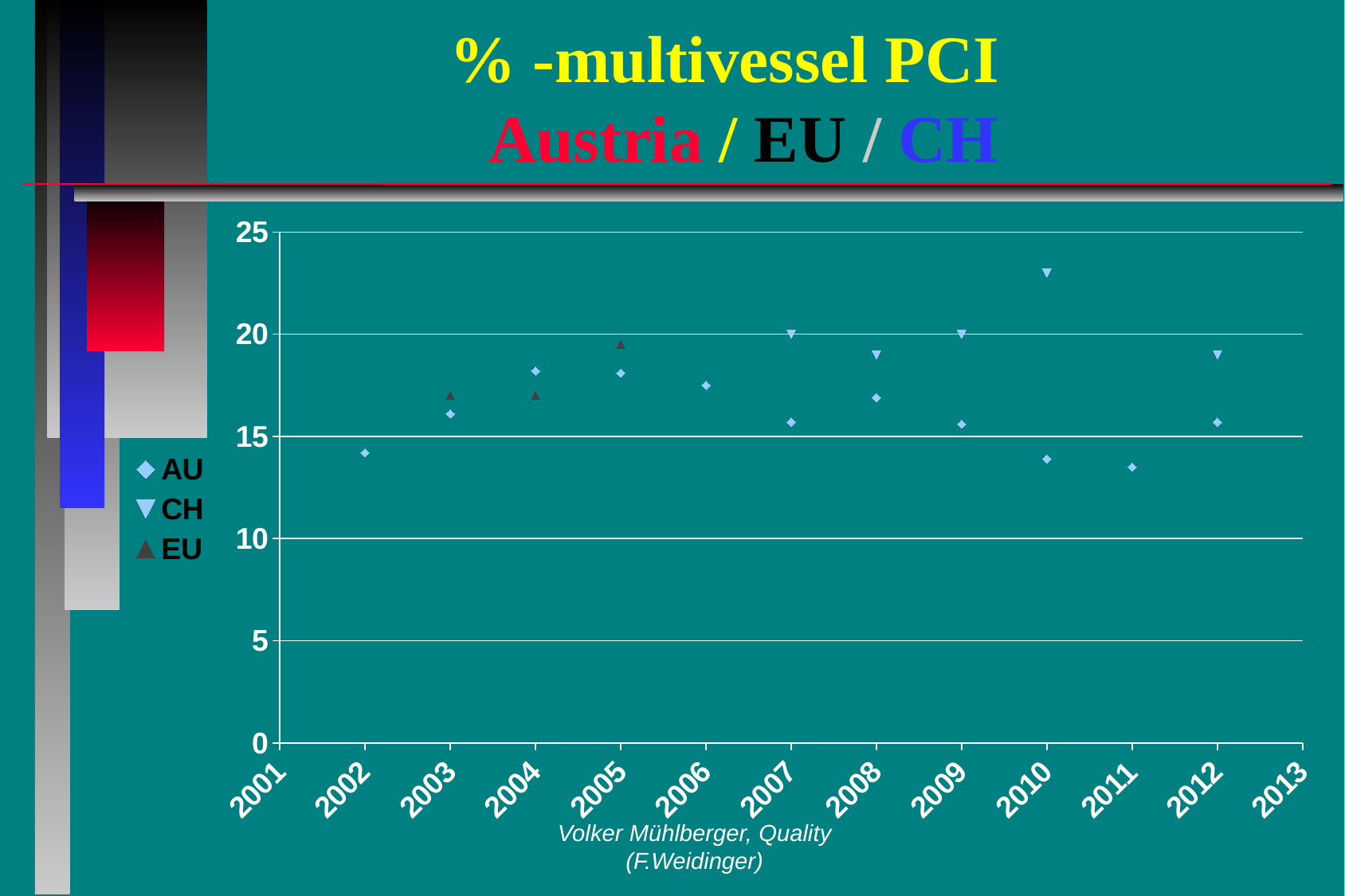
What is the title of the chart? % -multivessel PCI Austria / EU / CH Which series are listed in the legend? AU, CH, EU Is the value for AU in 2004 greater or less than 15? greater Is the value for CH in 2008 greater or less than 20? less What kind of chart is shown on the slide? scatter chart How many data points are plotted for the AU series? 11 Is the value for CH in 2010 greater or less than 20? greater In which year does the CH series reach its highest value? 2010 In 2010, which series has the larger value, AU or CH? CH How many series does the legend list? 3